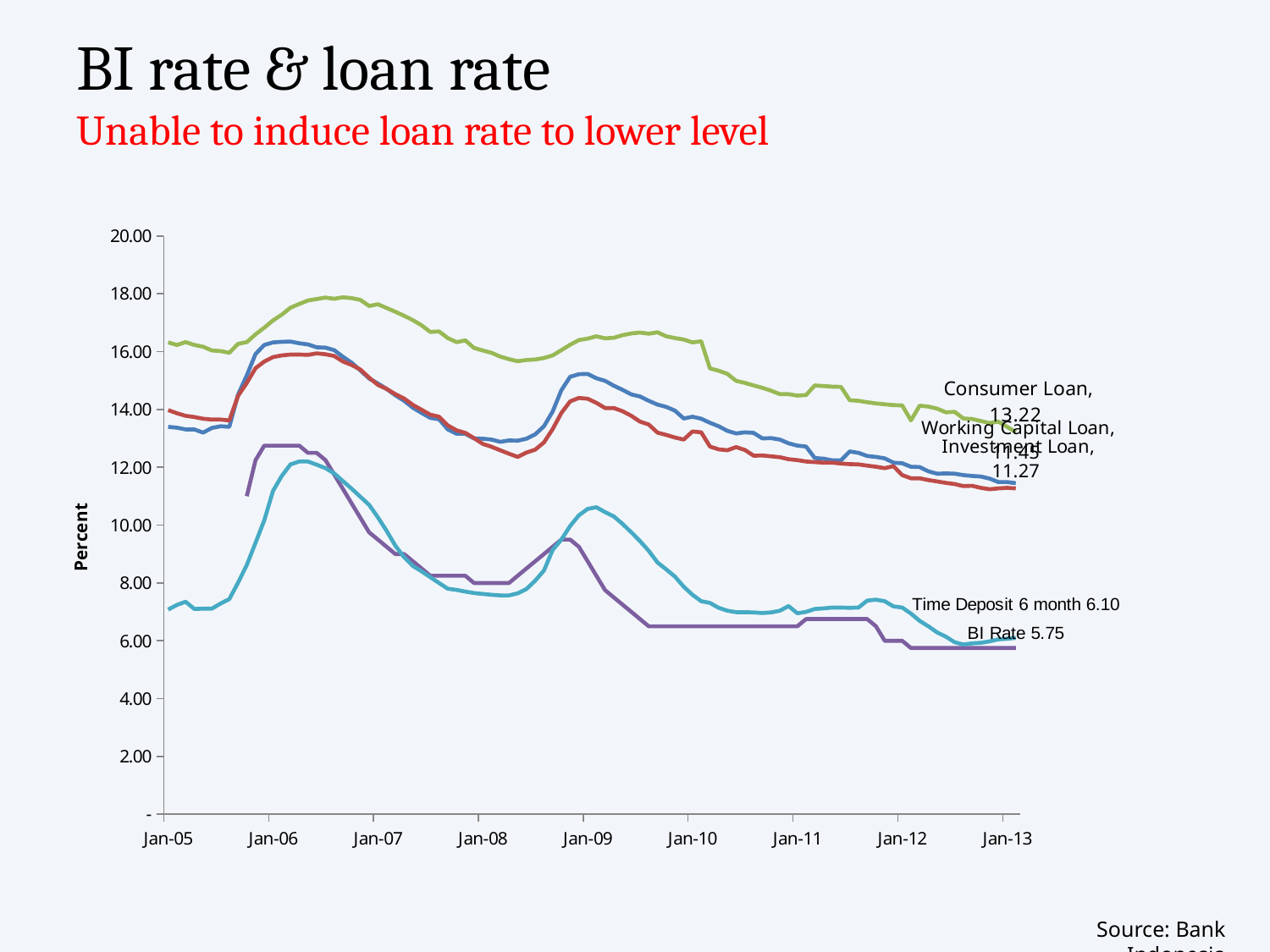
Is the value for BI Rate at Jan-10 greater or less than 8.00? less Is the value for Consumer Loan at Jan-06 greater or less than 16.00? greater What is the final value shown for Investment Loan? 11.27 What kind of chart is shown on the slide? line chart What is the final value shown for Time Deposit 6 month? 6.10 Which series has the lowest value at Jan-13? BI Rate What is the label on the vertical axis? Percent What is the final value shown for BI Rate? 5.75 What is the final value shown for Consumer Loan? 13.22 What is the difference between the final Time Deposit 6 month value and the final BI Rate value? 0.35 What is the difference between the final Consumer Loan value and the final Investment Loan value? 1.95 Which series has the highest value at Jan-13? Consumer Loan